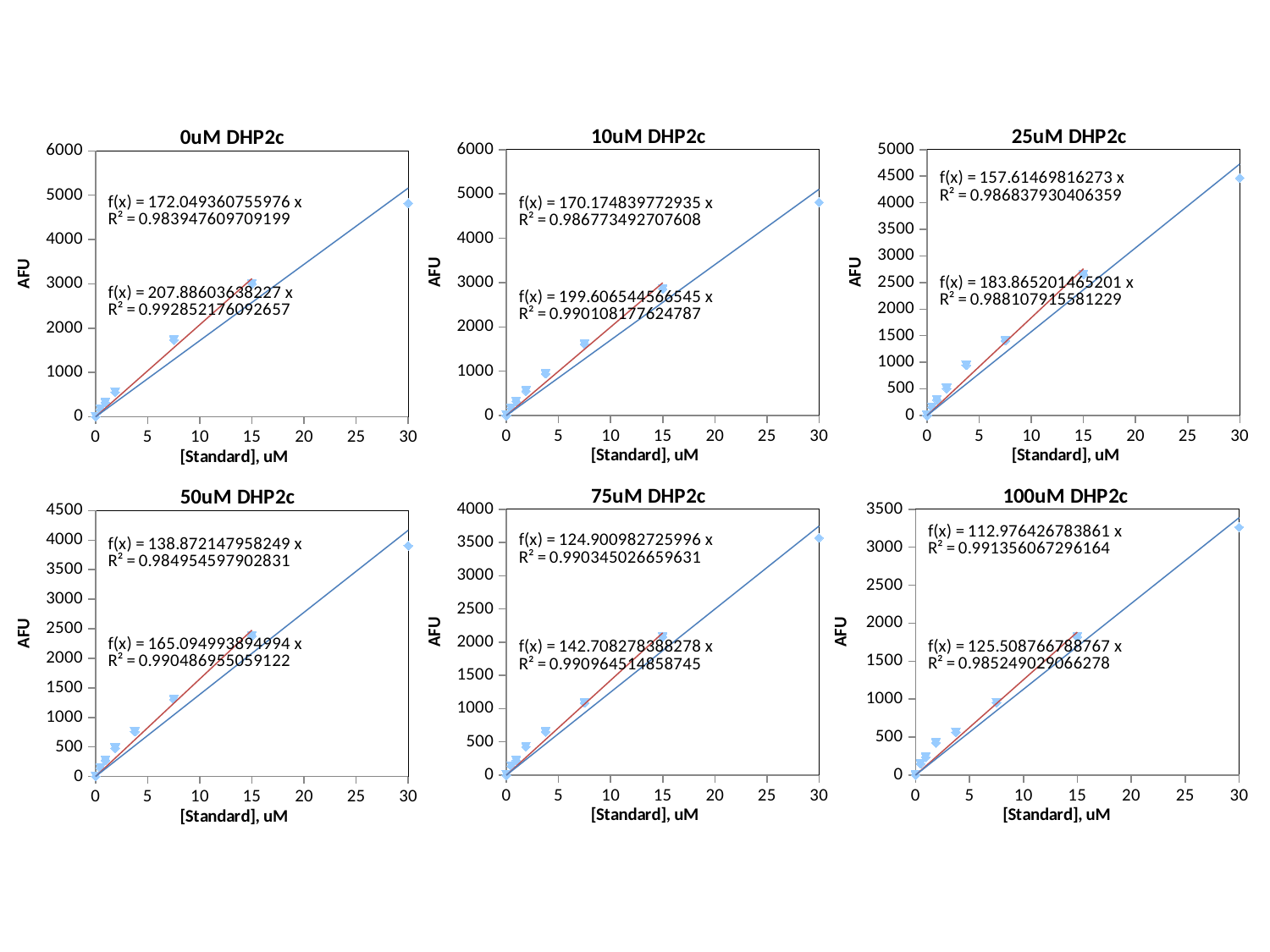
In the "75uM DHP2c" chart, is the AFU value at 30 uM greater or less than 3000? greater What is the x-axis label on the "50uM DHP2c" chart? [Standard], uM In the "10uM DHP2c" chart, is the AFU value at 7.5 uM greater or less than 1000? greater In the "25uM DHP2c" chart, is the AFU value at 30 uM greater or less than 4000? greater In the "100uM DHP2c" chart, do the AFU values rise or fall as the standard concentration increases? rise What kind of chart is the "0uM DHP2c" chart? scatter chart How many charts are shown on the slide? 6 What is the R² value of the upper trendline equation shown in the "100uM DHP2c" chart? 0.991356067296164